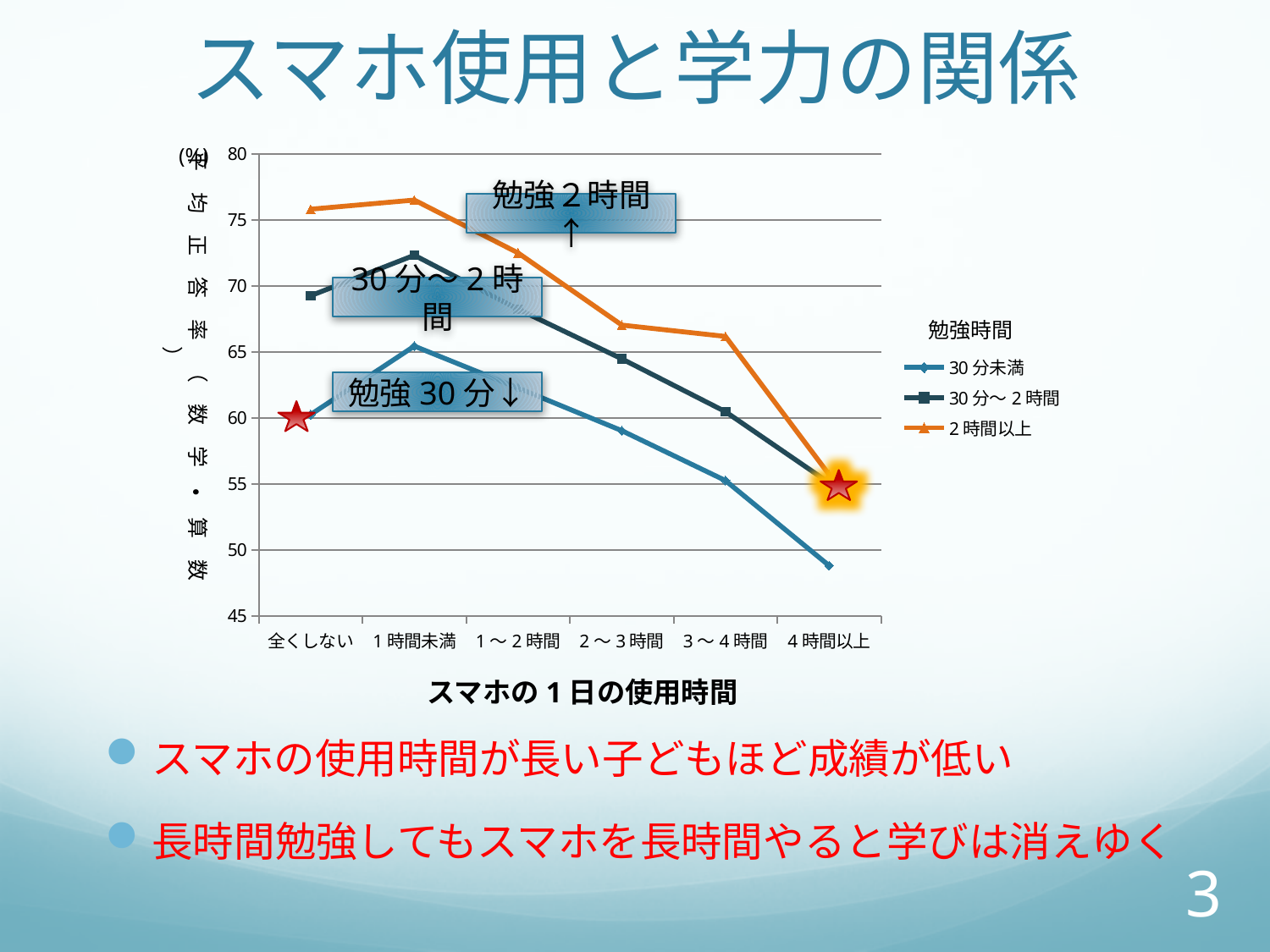
How many series does the legend list? 3 Is the value for 30分〜2時間 at 1時間未満 greater or less than 70? greater What is the x-axis title of the chart? スマホの1日の使用時間 What is the title of the legend? 勉強時間 How many categories are shown on the x axis? 6 What kind of chart is shown on the slide? line chart Does the 2時間以上 series rise or fall from 1時間未満 to 4時間以上? fall Which series has the lowest value at 4時間以上? 30分未満 Is the value for 2時間以上 at 1時間未満 greater or less than 75? greater Is the value for 30分未満 at 4時間以上 greater or less than 50? less Which series has the highest value at 1時間未満? 2時間以上